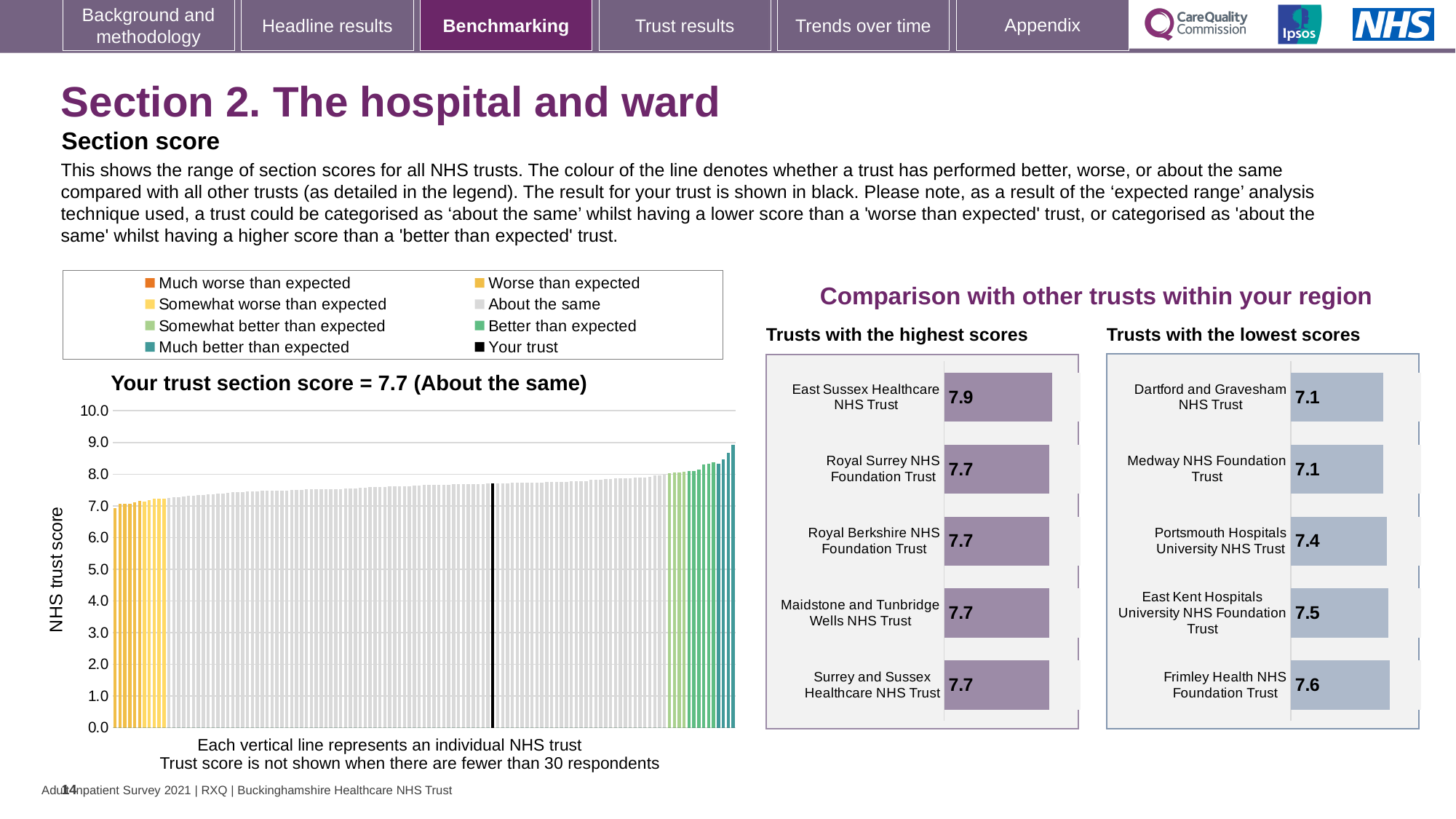
In the 'Trusts with the highest scores' chart, which trust has the highest score? East Sussex Healthcare NHS Trust In the main chart on the left, what is the section score for your trust? 7.7 In the 'Trusts with the lowest scores' chart, what kind of chart is used? Bar chart In the main chart on the left, is the value of the highest bar greater or less than 8.0? greater In the 'Trusts with the lowest scores' chart, what is the score for Portsmouth Hospitals University NHS Trust? 7.4 In the 'Trusts with the lowest scores' chart, what is the difference between the scores of Frimley Health NHS Foundation Trust and Dartford and Gravesham NHS Trust? 0.5 In the 'Trusts with the highest scores' chart, what is the score for East Sussex Healthcare NHS Trust? 7.9 In the 'Trusts with the highest scores' chart, how many trusts are shown? 5 In the 'Trusts with the lowest scores' chart, which has the larger score: Portsmouth Hospitals University NHS Trust or East Kent Hospitals University NHS Foundation Trust? East Kent Hospitals University NHS Foundation Trust In the main chart on the left, do the trust scores rise or fall from left to right? Rise In the 'Trusts with the highest scores' chart, what is the difference between the scores of East Sussex Healthcare NHS Trust and Royal Surrey NHS Foundation Trust? 0.2 In the 'Trusts with the lowest scores' chart, which trust has the highest score? Frimley Health NHS Foundation Trust